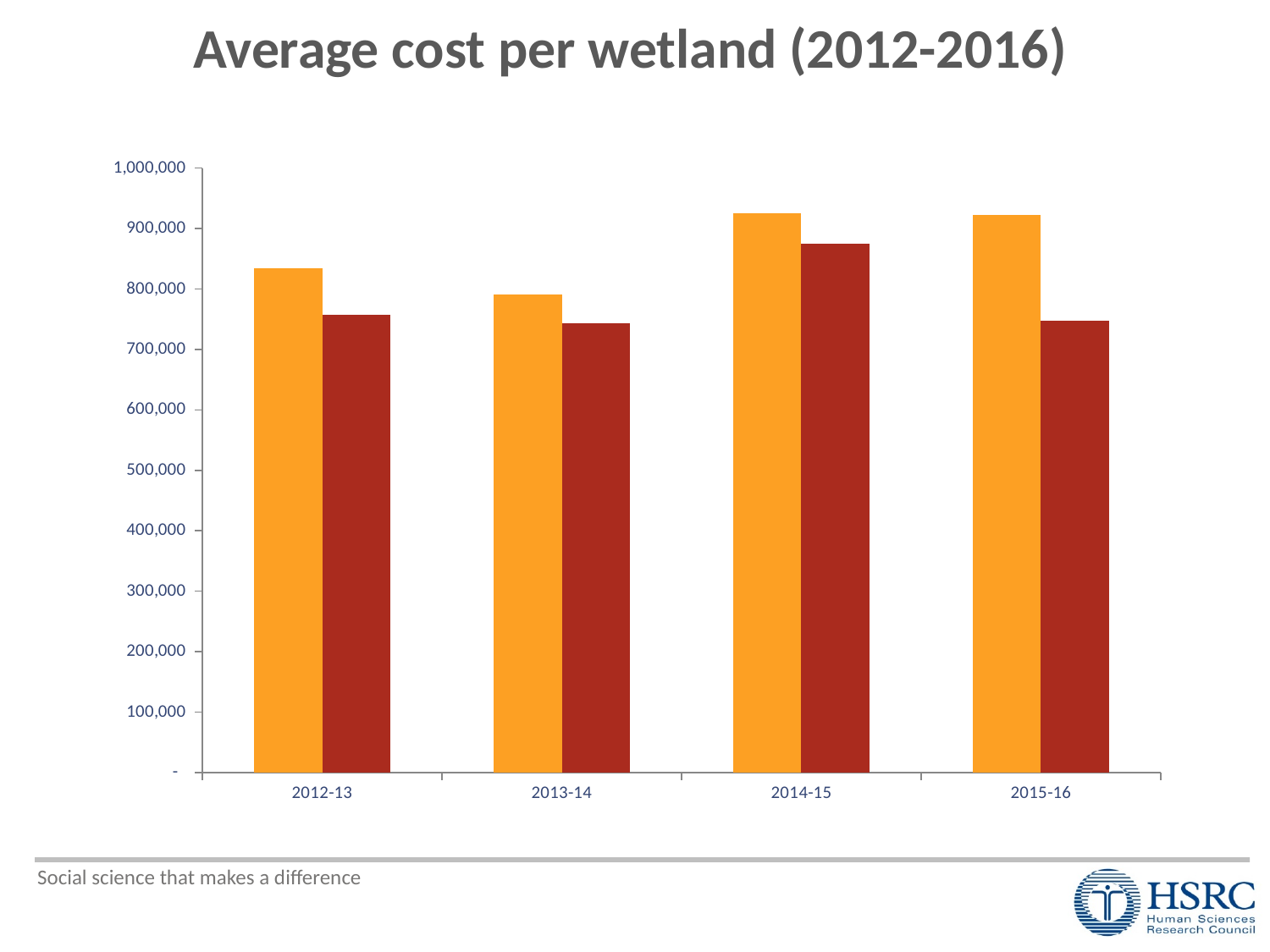
For 2015-16, which bar is larger, the orange bar or the dark red bar? The orange bar How many year categories are shown on the x axis? 4 Which is larger, the orange bar for 2012-13 or the orange bar for 2013-14? 2012-13 What is the title of the chart? Average cost per wetland (2012-2016) In which year is the orange bar lowest? 2013-14 What kind of chart is shown on the slide? Bar chart Is the value of the dark red bar for 2014-15 greater or less than 900,000? less Is the value of the orange bar for 2014-15 greater or less than 900,000? greater How many data series (bars per category) are plotted in the chart? 2 In which year is the dark red bar highest? 2014-15 Is the value of the dark red bar for 2012-13 greater or less than 700,000? greater